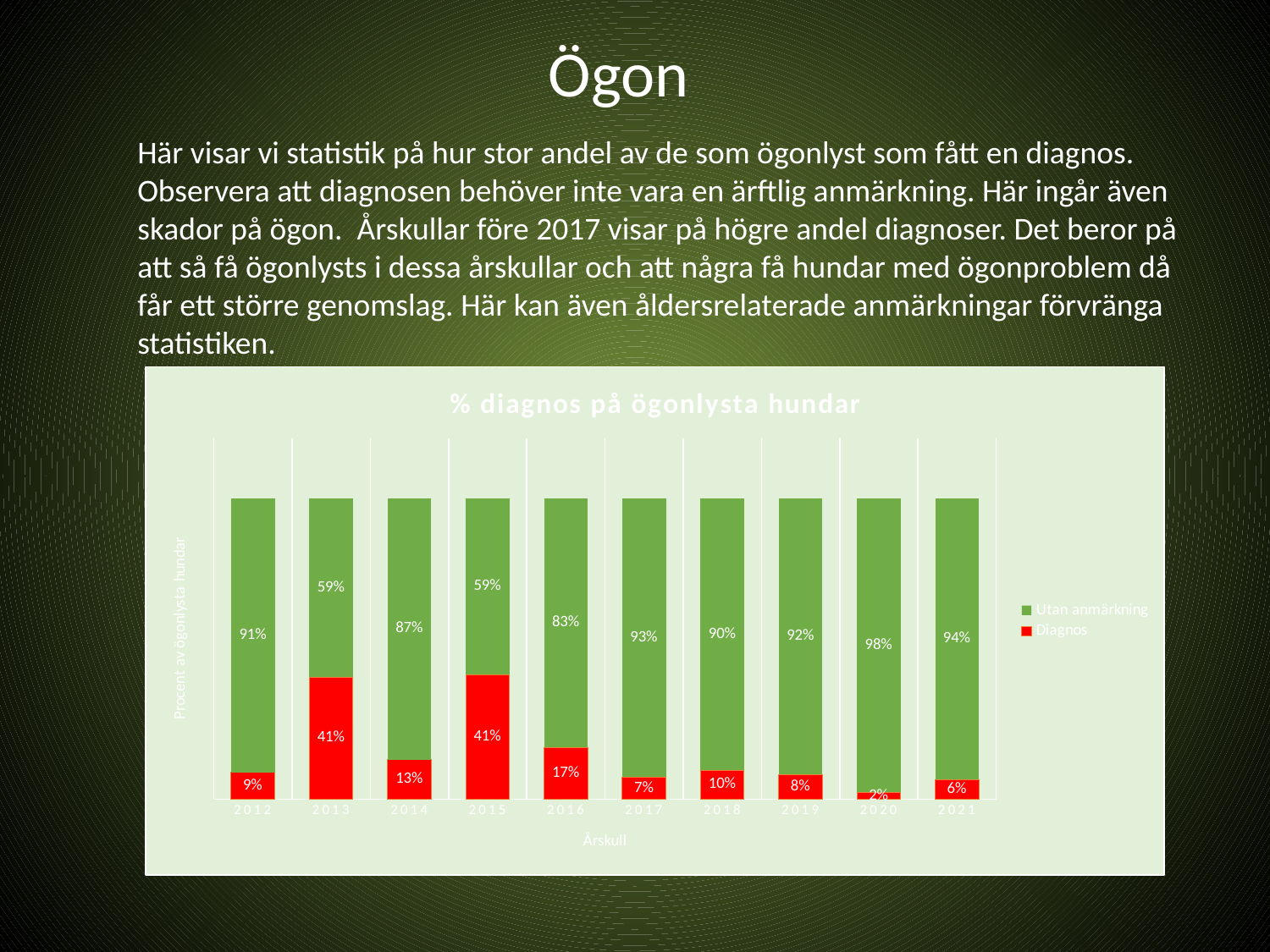
Which year has the lowest Diagnos value? 2020 What is the total of the stacked bar for 2017? 100% What kind of chart is shown? Stacked bar chart Which year has the highest Utan anmärkning value? 2020 What is the difference between the Diagnos values for 2014 and 2021? 7% What is the Utan anmärkning value for 2020? 98% What is the Diagnos value for 2013? 41% Which is larger, the Diagnos value for 2018 or for 2019? 2018 What is the Diagnos value for 2016? 17% How many series does the legend list? 2 What is the title of the chart? % diagnos på ögonlysta hundar How many years are shown on the x axis? 10